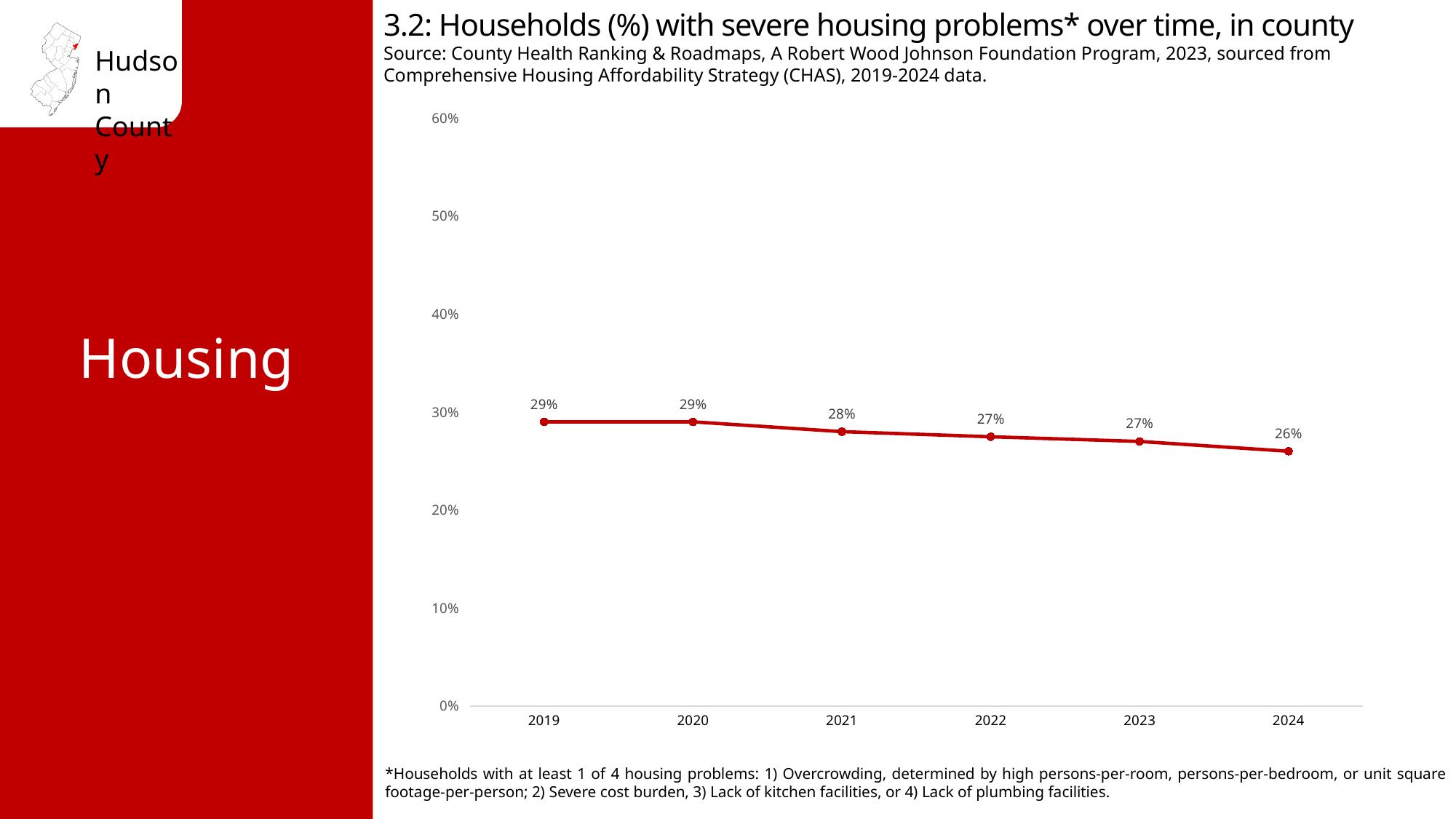
What is the value shown for 2022? 27% What is the value shown for 2021? 28% What percentage of households had severe housing problems in 2019? 29% Which year has the lowest percentage of households with severe housing problems? 2024 What kind of chart is shown on the slide? line chart Which is larger, the value for 2020 or the value for 2023? 2020 What is the difference in percentage points between the 2019 value and the 2024 value? 3 Do the values rise or fall from 2019 to 2024? fall Is the value for 2021 greater or less than 30%? less What is the title of the chart? 3.2: Households (%) with severe housing problems* over time, in county What percentage of households had severe housing problems in 2024? 26% How many years are plotted on the chart? 6